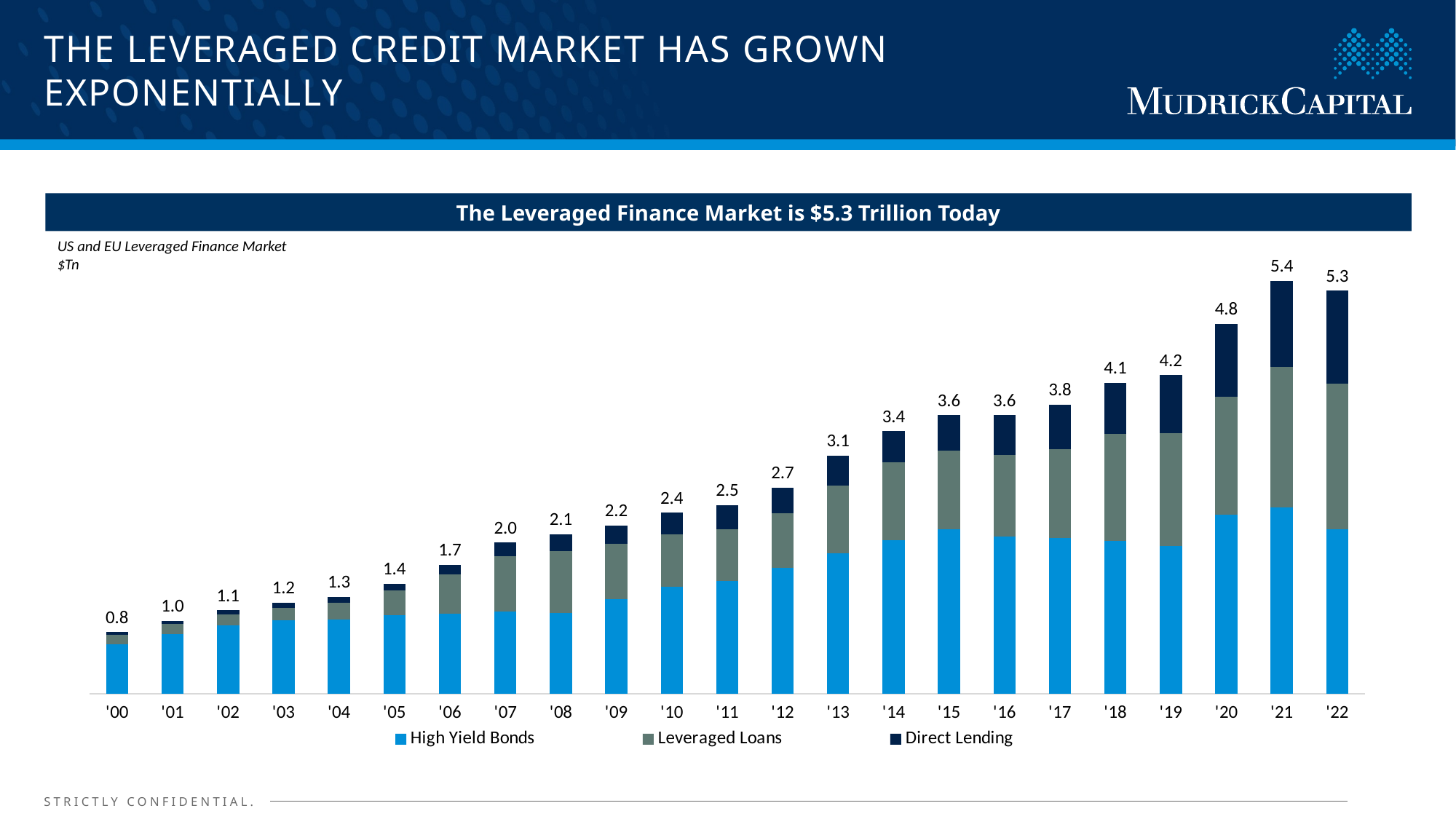
How many series does the legend list? 3 Which is larger, the total for '18 or the total for '19? '19 Which year has the lowest total value? '00 What is the total leveraged finance market value labelled for '22? 5.3 What is the difference between the total for '21 and the total for '20? 0.6 Which year has the highest total value? '21 What is the total value labelled for '00? 0.8 Do the total values generally rise or fall from '00 to '21? Rise Which series is shown in the lightest blue colour at the bottom of each bar? High Yield Bonds What type of chart is shown on the slide? Stacked bar chart How many years are plotted along the x axis? 23 What is the total value labelled for '13? 3.1